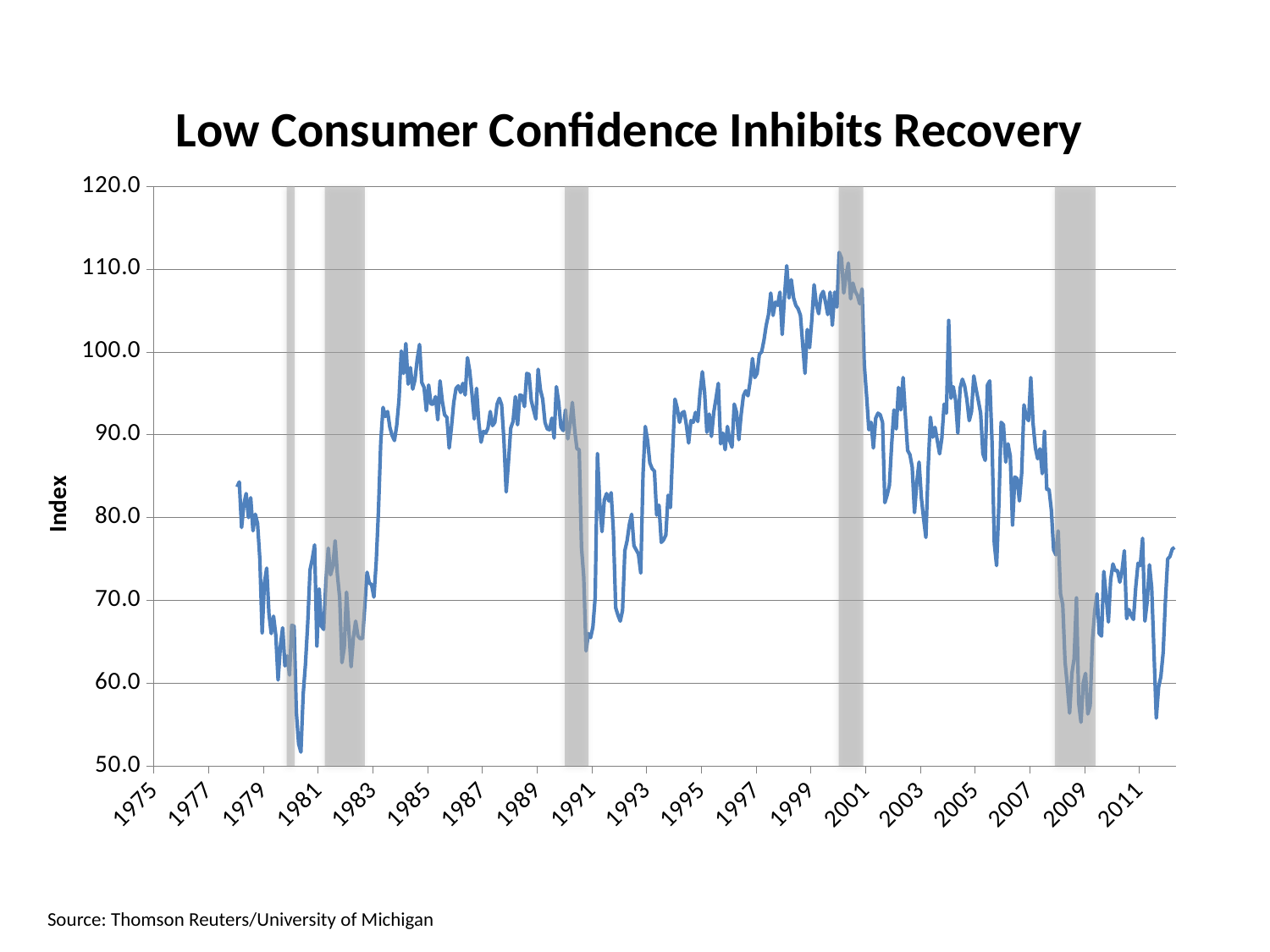
What is the label on the vertical axis of the chart? Index Is the consumer confidence index at its low point in 1980 greater or less than 60.0? less Is the consumer confidence index at its low point in 2009 greater or less than 60.0? less Does the consumer confidence index generally rise or fall between 2000 and 2008? fall Is the consumer confidence index in 2011 greater or less than 80.0? less Which is higher: the peak of the index around 2000 or the peak around 1985? the peak around 2000 How many gray shaded bands are drawn on the chart? 5 What kind of chart is shown on the slide? line chart What is the title of the chart? Low Consumer Confidence Inhibits Recovery Does the consumer confidence index generally rise or fall between 1991 and 1999? rise